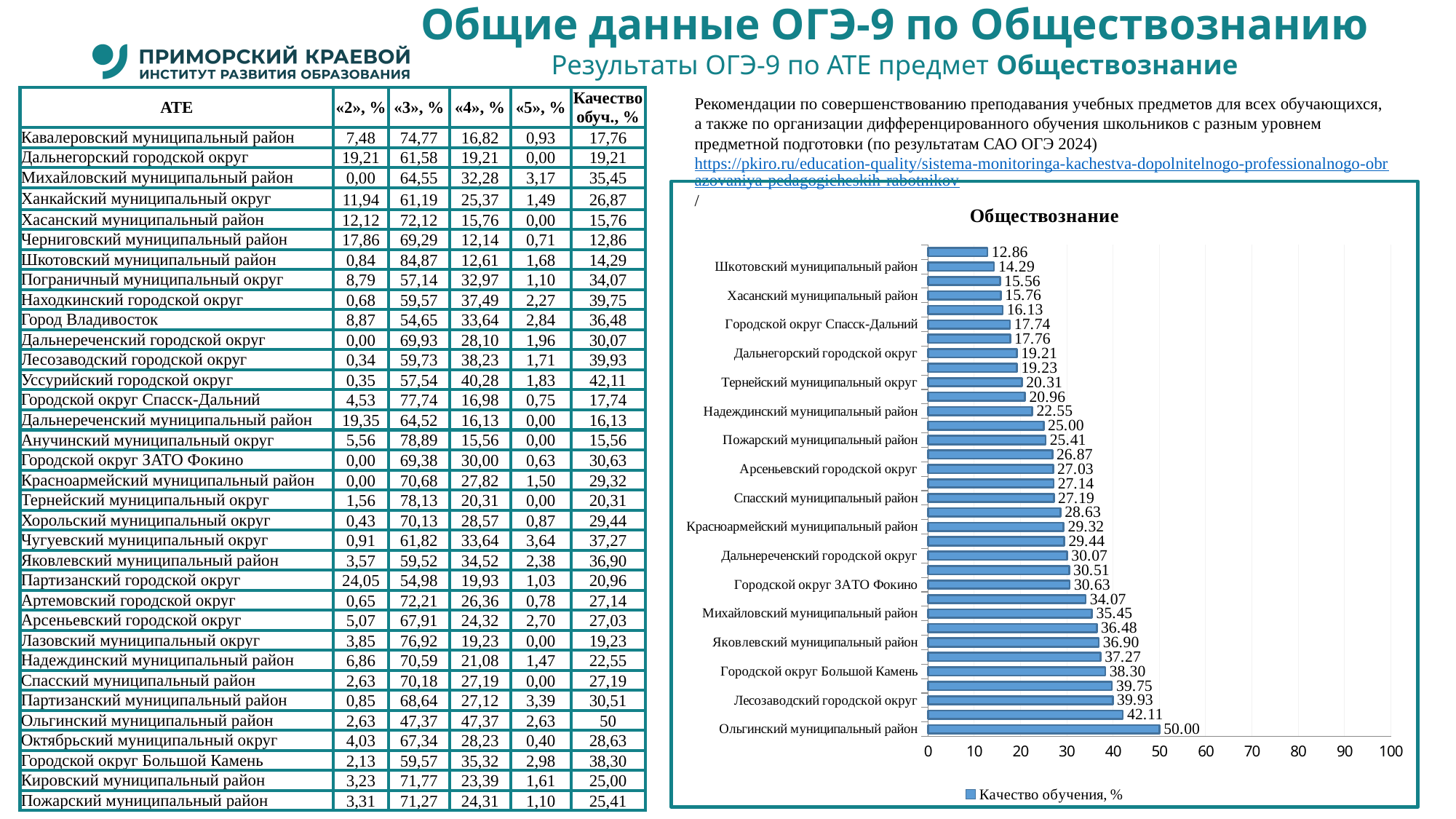
Which category has the highest value in the chart? Ольгинский муниципальный район What is the value for Шкотовский муниципальный район in the chart? 14.29 Is the value for Михайловский муниципальный район greater or less than 30? greater How many series does the chart legend list? 1 Do the bar values increase or decrease going from the top of the chart to the bottom? Increase What kind of chart is shown on the slide? Bar chart Which has a larger value: Пожарский муниципальный район or Красноармейский муниципальный район? Красноармейский муниципальный район What is the difference between the values for Ольгинский муниципальный район and Шкотовский муниципальный район? 35.71 What is the value for Ольгинский муниципальный район in the chart? 50.00 What is the title of the chart? Обществознание What is the lowest value shown in the chart? 12.86 What is the value for Городской округ Большой Камень in the chart? 38.30